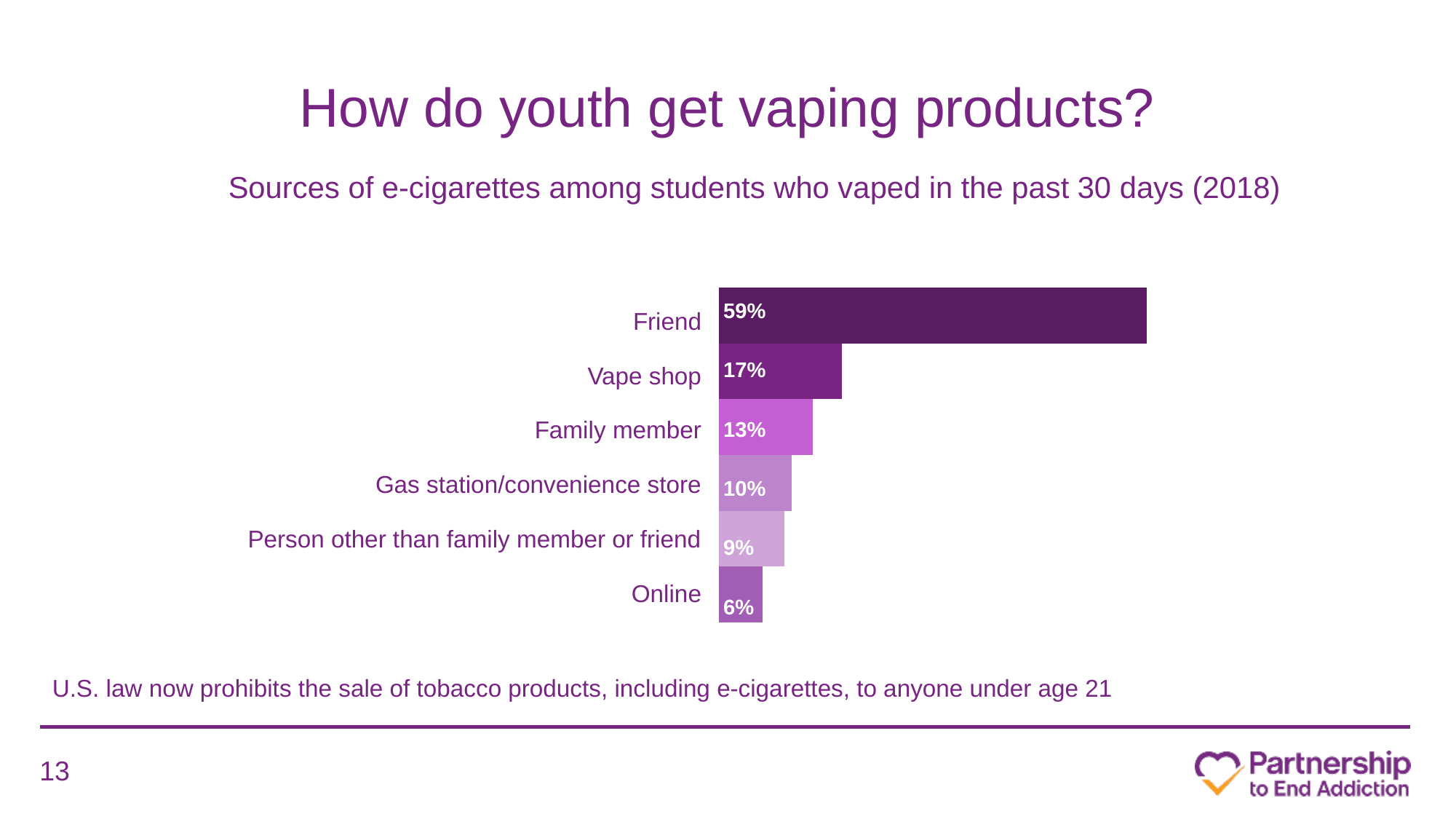
How many sources (categories) are shown in the chart? 6 Which is larger, the value for Family member or the value for Person other than family member or friend? Family member What is the value shown for Family member? 13% Which source has the lowest percentage? Online What percentage of students who vaped in the past 30 days got e-cigarettes from a friend? 59% What is the subtitle describing the chart's data? Sources of e-cigarettes among students who vaped in the past 30 days (2018) What is the value shown for Gas station/convenience store? 10% What kind of chart is shown on the slide? Bar chart What is the difference between the Friend and Vape shop percentages? 42% Which source has the highest percentage? Friend What is the value shown for Online? 6% What is the value shown for Vape shop? 17%